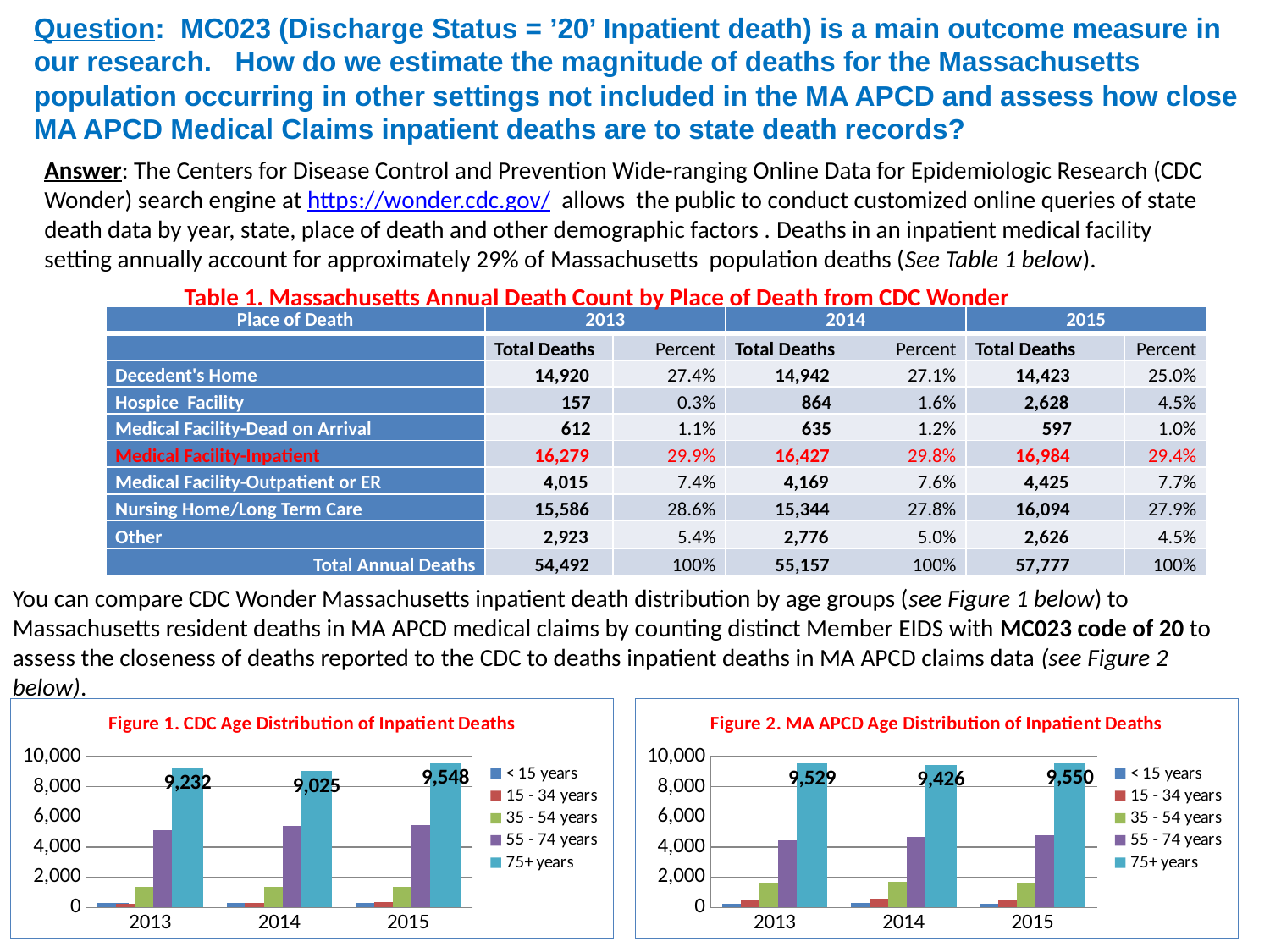
In Figure 1, is the 75+ years value larger in 2013 or in 2014? 2013 In Figure 1, what is the value for the 75+ years series in 2013? 9,232 In Figure 2, what is the value for the 75+ years series in 2014? 9,426 In Figure 2, which year has the lowest value for the 75+ years series? 2014 In Figure 2, what is the difference between the 75+ years values for 2015 and 2014? 124 In Figure 1, which year has the highest value for the 75+ years series? 2015 In Figure 1, is the value for the 55 - 74 years series in 2013 greater or less than 4,000? greater What kind of chart is Figure 1? Bar chart In Figure 1, what is the value for the 75+ years series in 2014? 9,025 How many series does the legend of Figure 2 list? 5 In Figure 2, what is the value for the 75+ years series in 2015? 9,550 In Figure 1, what is the difference between the 75+ years values for 2015 and 2014? 523